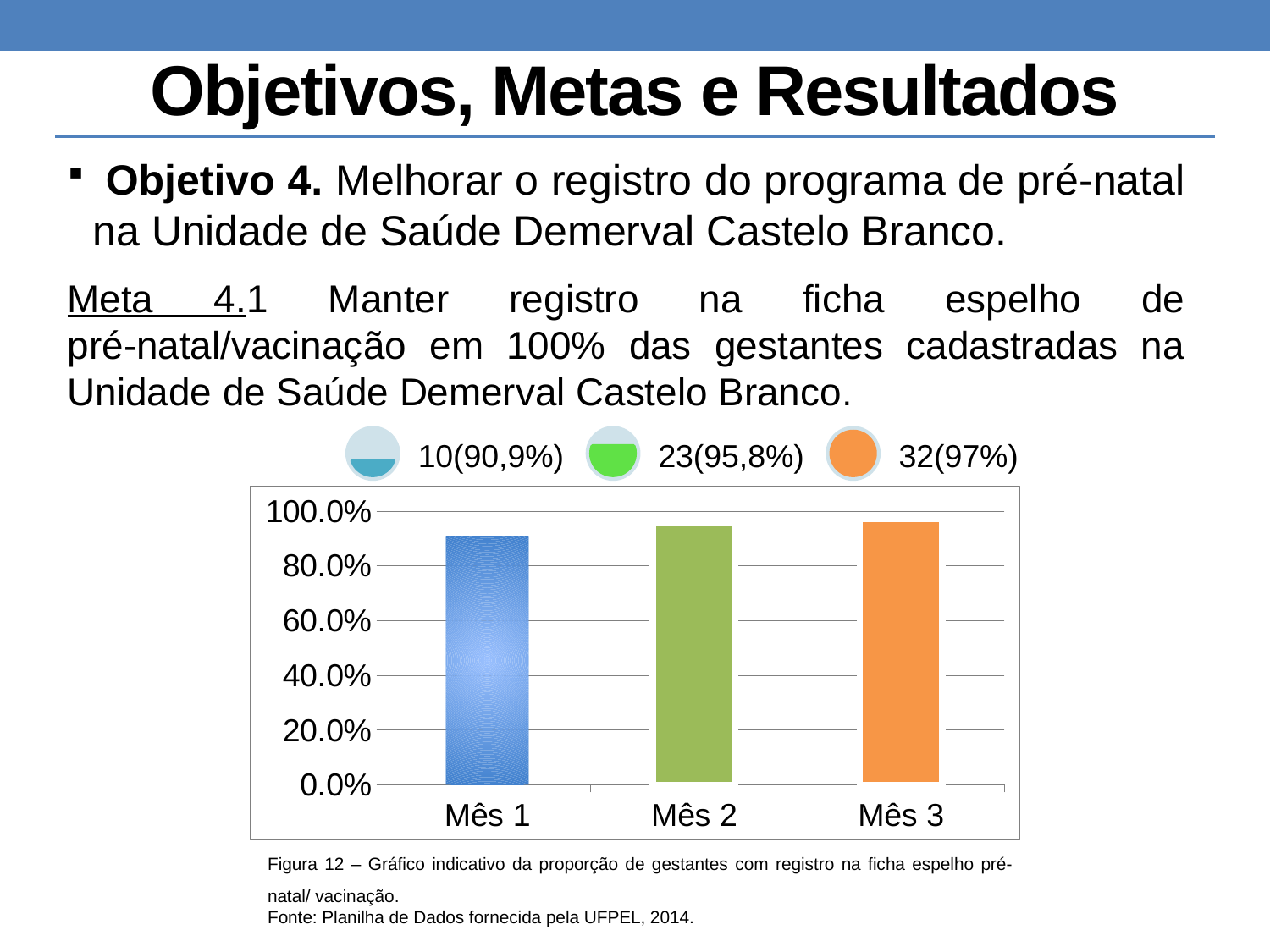
Is the value for Mês 3 greater or less than 80.0%? greater Which month has the lowest bar in the chart? Mês 1 Which month has the highest bar in the chart? Mês 3 According to the label above the chart, what value is shown for the orange series (Mês 3)? 32(97%) What kind of chart is shown on the slide? bar chart Which is larger, the bar for Mês 2 or the bar for Mês 1? Mês 2 What is the highest tick value shown on the y axis of the chart? 100.0% Is the value for Mês 1 greater or less than 80.0%? greater Is the value for Mês 1 greater or less than 100.0%? less According to the label above the chart, what value is shown for the blue series (Mês 1)? 10(90,9%) Do the bar values rise or fall from Mês 1 to Mês 3? rise How many categories (months) are plotted on the x axis of the chart? 3